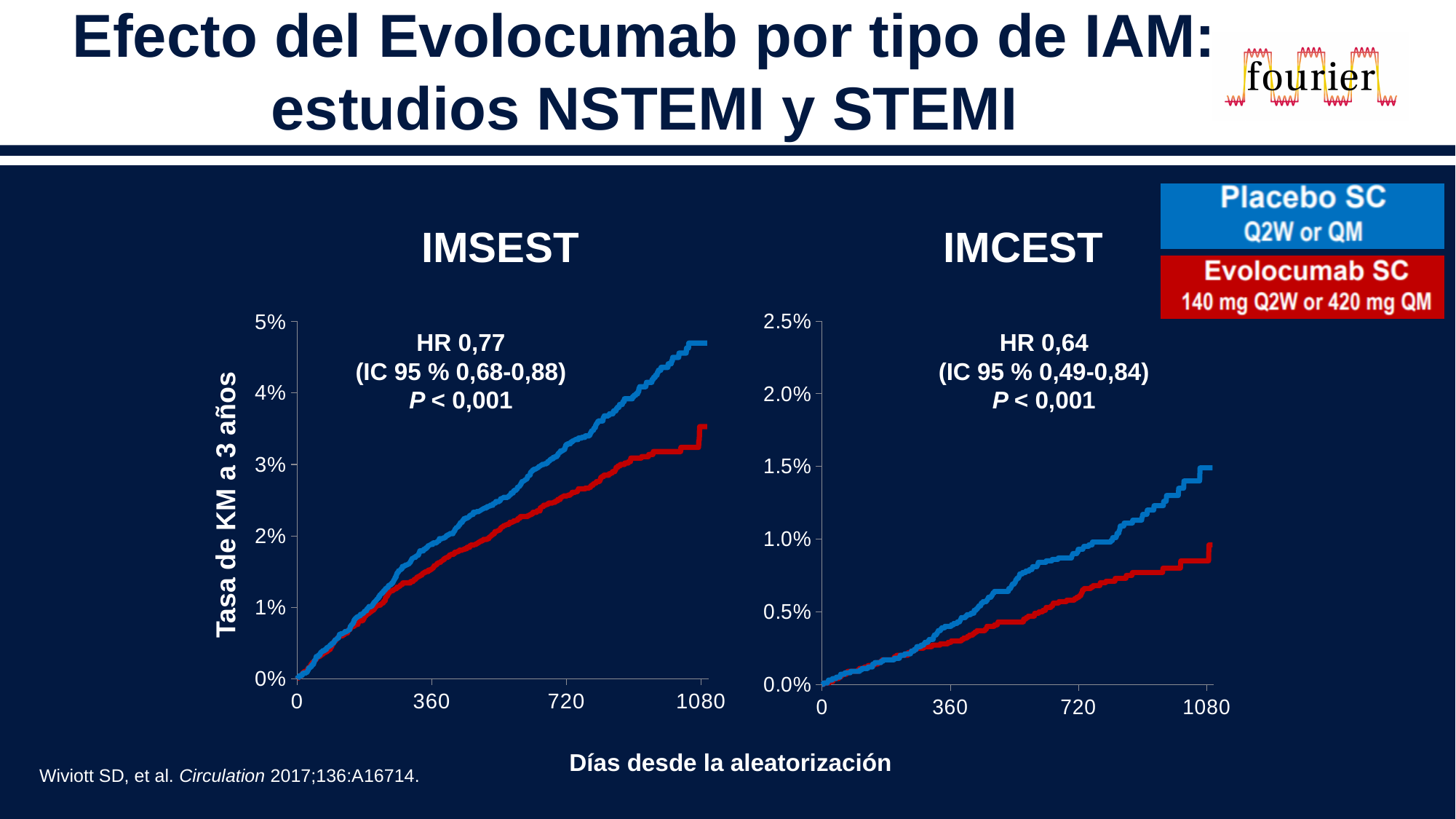
In the IMCEST chart, does the Evolocumab SC curve rise or fall along the x axis? Rise In the IMSEST chart, does the Placebo SC curve rise or fall as days since randomization increase? Rise In the IMCEST chart, is the Placebo SC value at 1080 days greater or less than 1.0%? greater How many series does the legend list? 2 In the IMSEST chart, which series has the higher value at 1080 days, Placebo SC or Evolocumab SC? Placebo SC In the IMCEST chart, which series has the lower value at 1080 days, Placebo SC or Evolocumab SC? Evolocumab SC In the IMSEST chart, is the Placebo SC value at 1080 days greater or less than 4%? greater In the IMSEST chart, is the Evolocumab SC value at 1080 days greater or less than 4%? less What kind of chart is the IMSEST chart? Line chart Which colour represents Evolocumab SC in the legend? Red What hazard ratio is printed on the IMCEST chart? HR 0,64